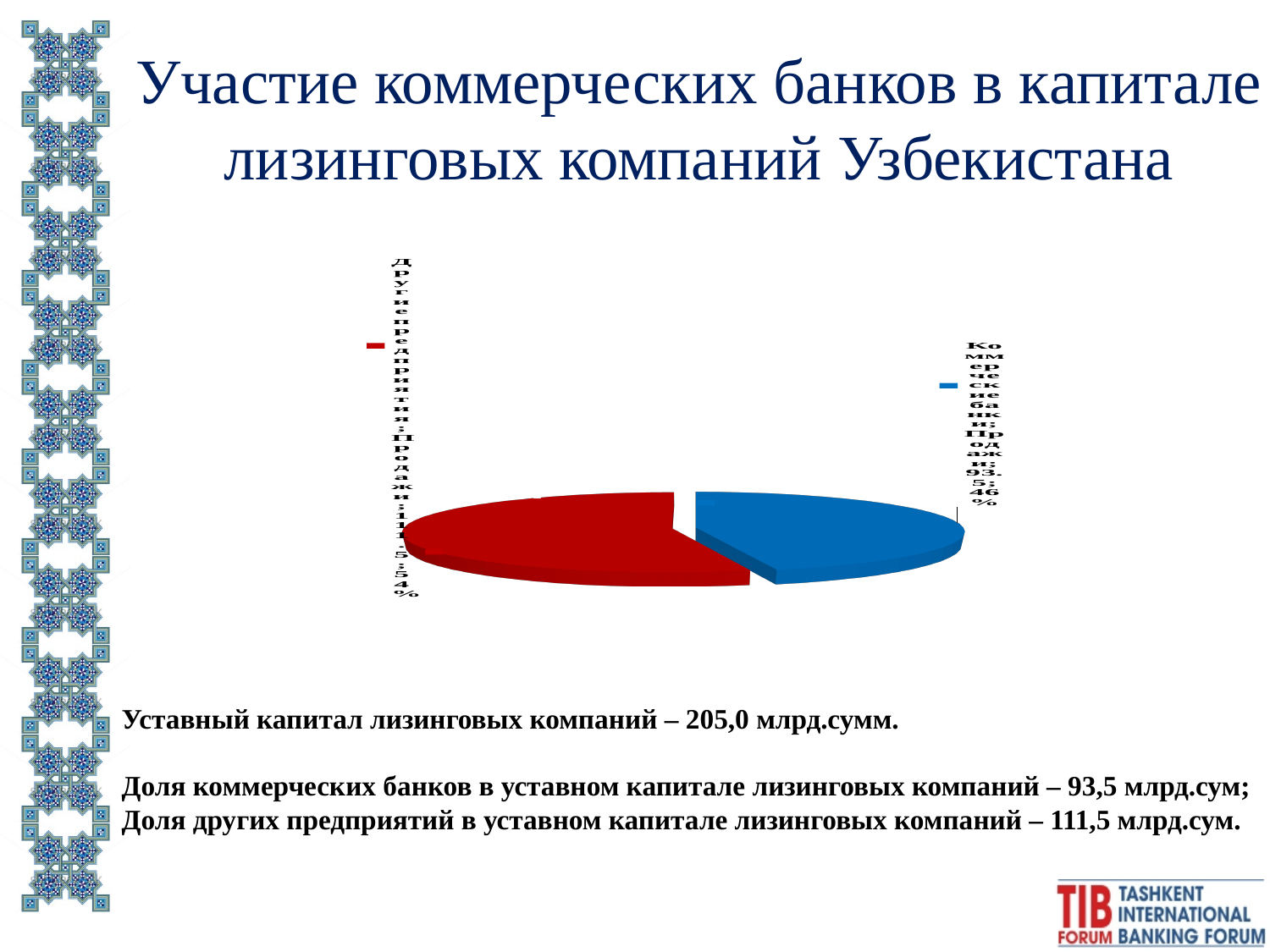
How many slices does the pie chart have? 2 What share of the pie does the slice Другие предприятия represent? 54% Which slice of the pie chart is the smallest? Коммерческие банки What colour is the slice for Другие предприятия? red What is the difference between the values for Другие предприятия and Коммерческие банки? 18,0 Which slice of the pie chart is the largest? Другие предприятия What colour is the slice for Коммерческие банки? blue What kind of chart is shown on the slide? pie chart Which is larger, the slice for Коммерческие банки or the slice for Другие предприятия? Другие предприятия What value is shown for the slice Другие предприятия? 111,5 What value is shown for the slice Коммерческие банки? 93,5 What share of the pie does the slice Коммерческие банки represent? 46%